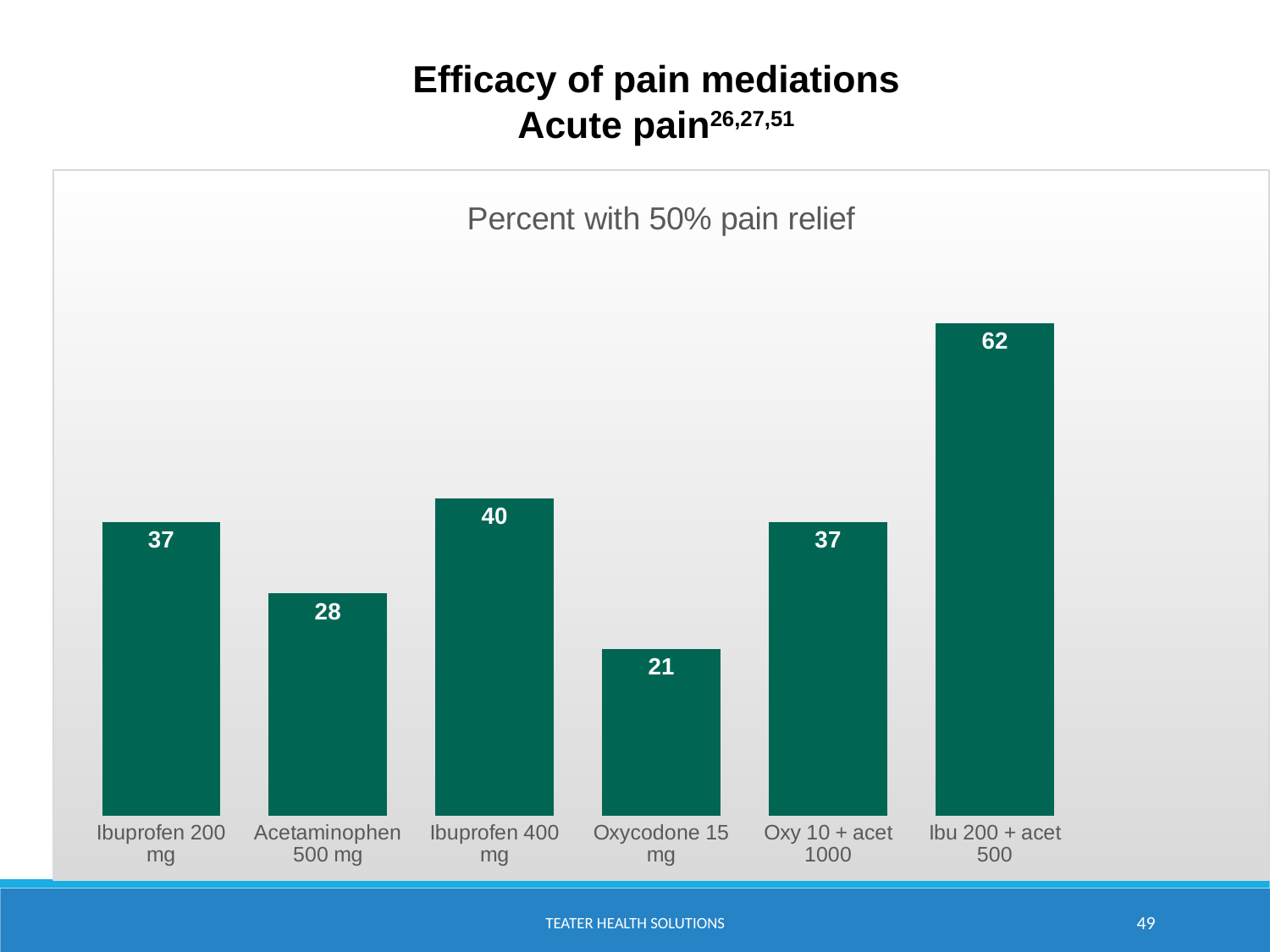
What is the value for Ibuprofen 200 mg? 37 How many categories are shown in the chart? 6 Which category has the highest value? Ibu 200 + acet 500 What is the difference between the values for Ibu 200 + acet 500 and Ibuprofen 400 mg? 22 What is the value for Oxycodone 15 mg? 21 What is the difference between the values for Acetaminophen 500 mg and Oxycodone 15 mg? 7 What is the value for Ibu 200 + acet 500? 62 What is the title of the chart? Percent with 50% pain relief Which category has the lowest value? Oxycodone 15 mg What is the value for Acetaminophen 500 mg? 28 Which is larger, the value for Ibuprofen 400 mg or the value for Acetaminophen 500 mg? Ibuprofen 400 mg What kind of chart is shown on the slide? Bar chart